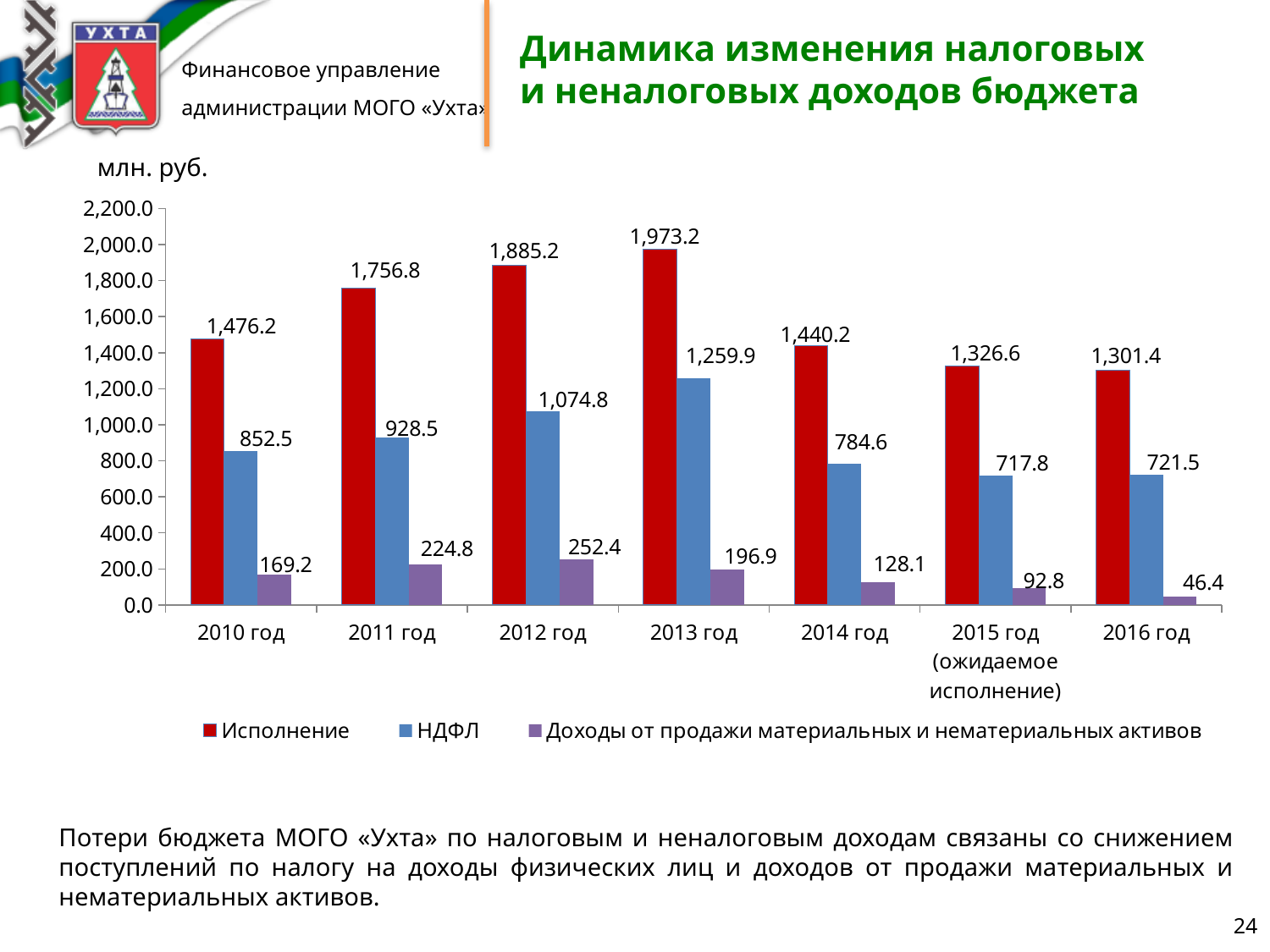
How many year categories are shown on the x axis? 7 In which year is Исполнение the highest? 2013 год What is the value of НДФЛ for 2012 год? 1,074.8 How does Исполнение change from 2013 год to 2016 год? It falls Is the value of НДФЛ for 2015 год greater or less than 800.0? less What is the value of Доходы от продажи материальных и нематериальных активов for 2016 год? 46.4 How many series does the legend list? 3 What is the difference between Исполнение in 2013 год and in 2016 год? 671.8 What is the value of Исполнение for 2013 год? 1,973.2 What type of chart is shown on the slide? Bar chart Which is larger: Исполнение in 2011 год or in 2012 год? 2012 год In which year is Доходы от продажи материальных и нематериальных активов the lowest? 2016 год